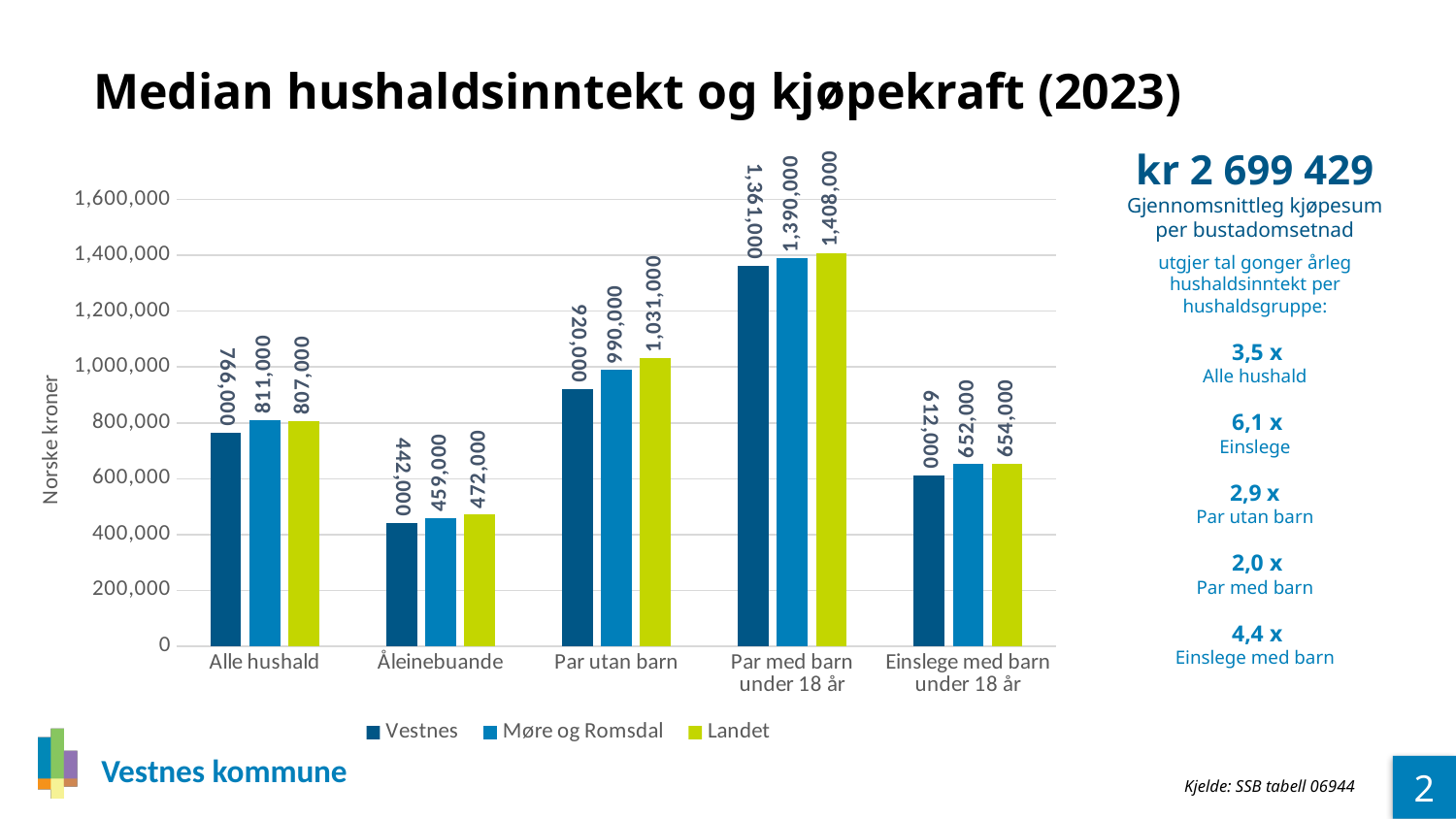
What is the value for Møre og Romsdal in the Par med barn under 18 år category? 1,390,000 What kind of chart is shown on the slide? Bar chart What is the value for Vestnes in the Alle hushald category? 766,000 How many categories are shown on the x axis? 5 How many series does the legend list? 3 What is the value for Landet in the Par utan barn category? 1,031,000 Which category has the highest value for Landet? Par med barn under 18 år What is the difference between the Landet and Vestnes values in the Par utan barn category? 111,000 What is the label of the y axis? Norske kroner Which is larger in the Alle hushald category: Møre og Romsdal or Landet? Møre og Romsdal What is the value for Vestnes in the Einslege med barn under 18 år category? 612,000 Which category has the lowest value for Vestnes? Åleinebuande